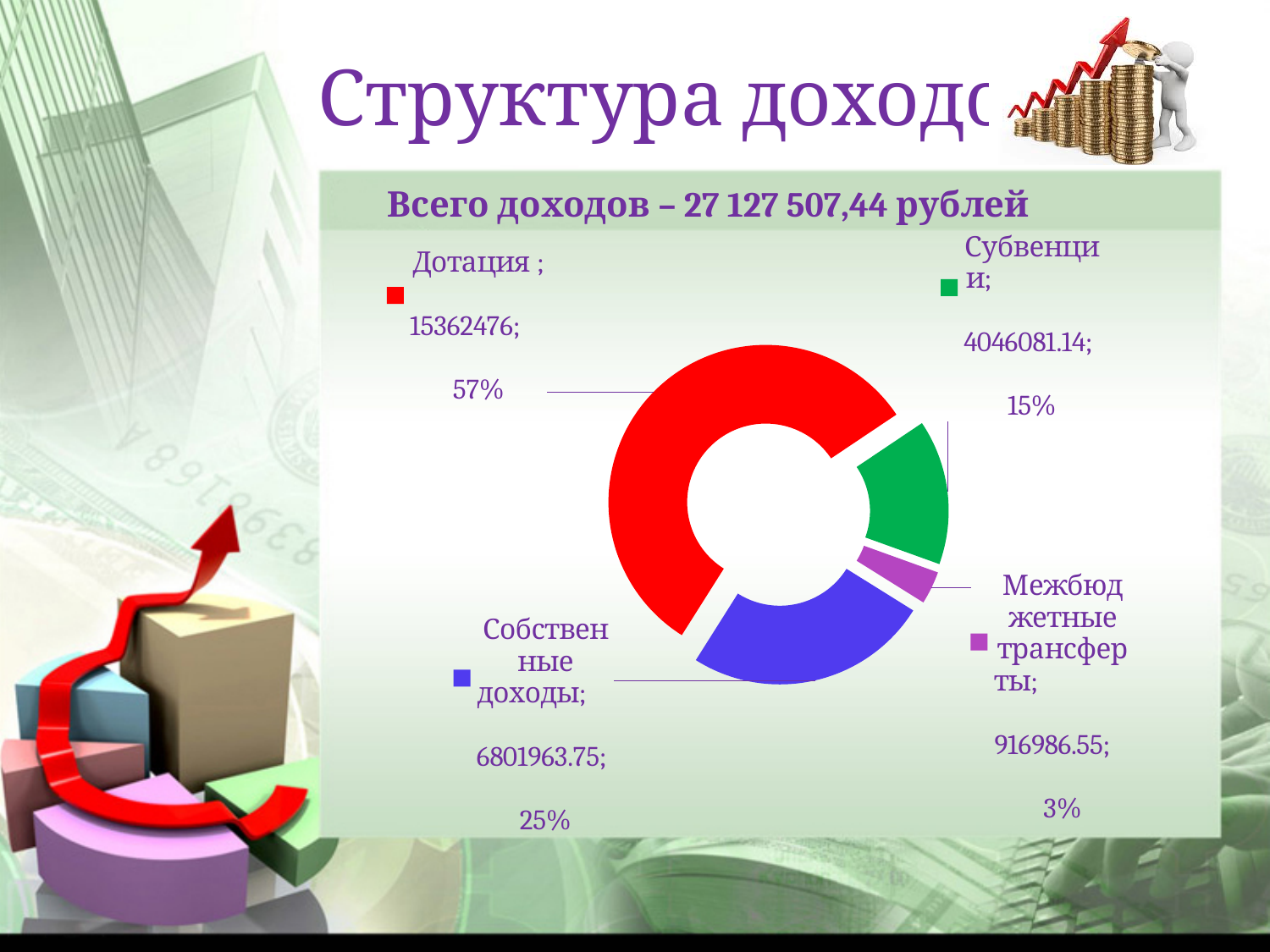
How many categories does the chart show? 4 Which category has the smallest value? Межбюджетные трансферты What is the value for Дотация? 15362476 What total income is stated above the chart? 27 127 507,44 рублей Which category has the largest value? Дотация What share of the chart does Дотация represent? 57% What is the value for Субвенции? 4046081.14 What is the value for Межбюджетные трансферты? 916986.55 What share of the chart does Собственные доходы represent? 25% What kind of chart is shown on the slide? doughnut chart What is the value for Собственные доходы? 6801963.75 Which is larger, Субвенции or Собственные доходы? Собственные доходы